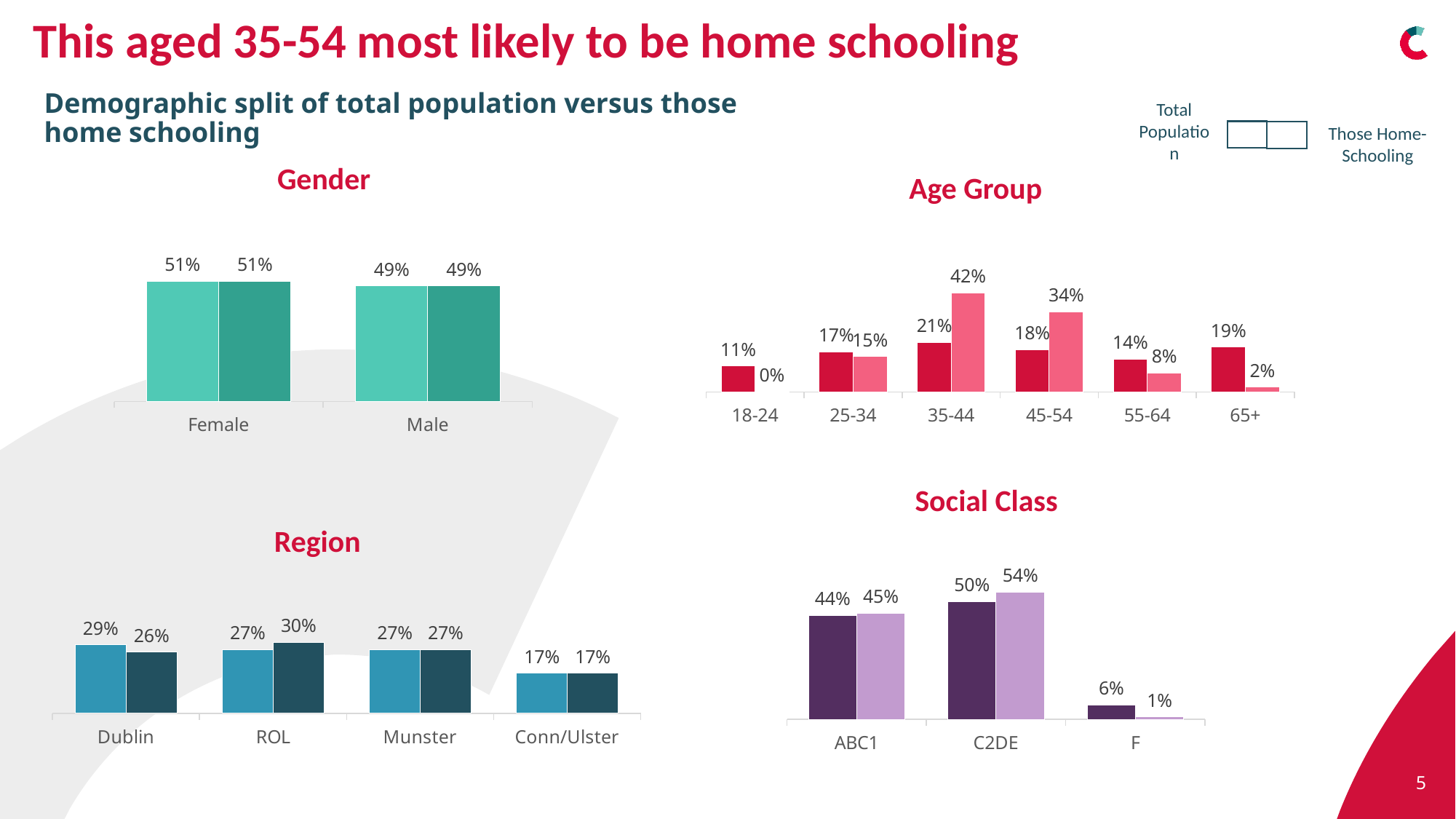
In the Social Class chart, what is the difference between the Total Population and Those Home-Schooling values for F? 5% How many series does the legend at the top right of the slide list? 2 In the Age Group chart, how many age groups are shown on the x axis? 6 In the Gender chart, what is the Total Population value for Male? 49% In the Region chart, what is the Those Home-Schooling value for ROL? 30% In the Region chart, is the Total Population value for Dublin larger or smaller than the Those Home-Schooling value for Dublin? larger In the Age Group chart, what is the difference between the Those Home-Schooling value and the Total Population value for 45-54? 16% In the Social Class chart, what is the Those Home-Schooling value for C2DE? 54% In the Region chart, which region has the lowest Total Population value? Conn/Ulster In the Age Group chart, what is the Total Population value for 65+? 19% In the Age Group chart, which age group has the highest Those Home-Schooling value? 35-44 In the Age Group chart, what is the Those Home-Schooling value for 35-44? 42%